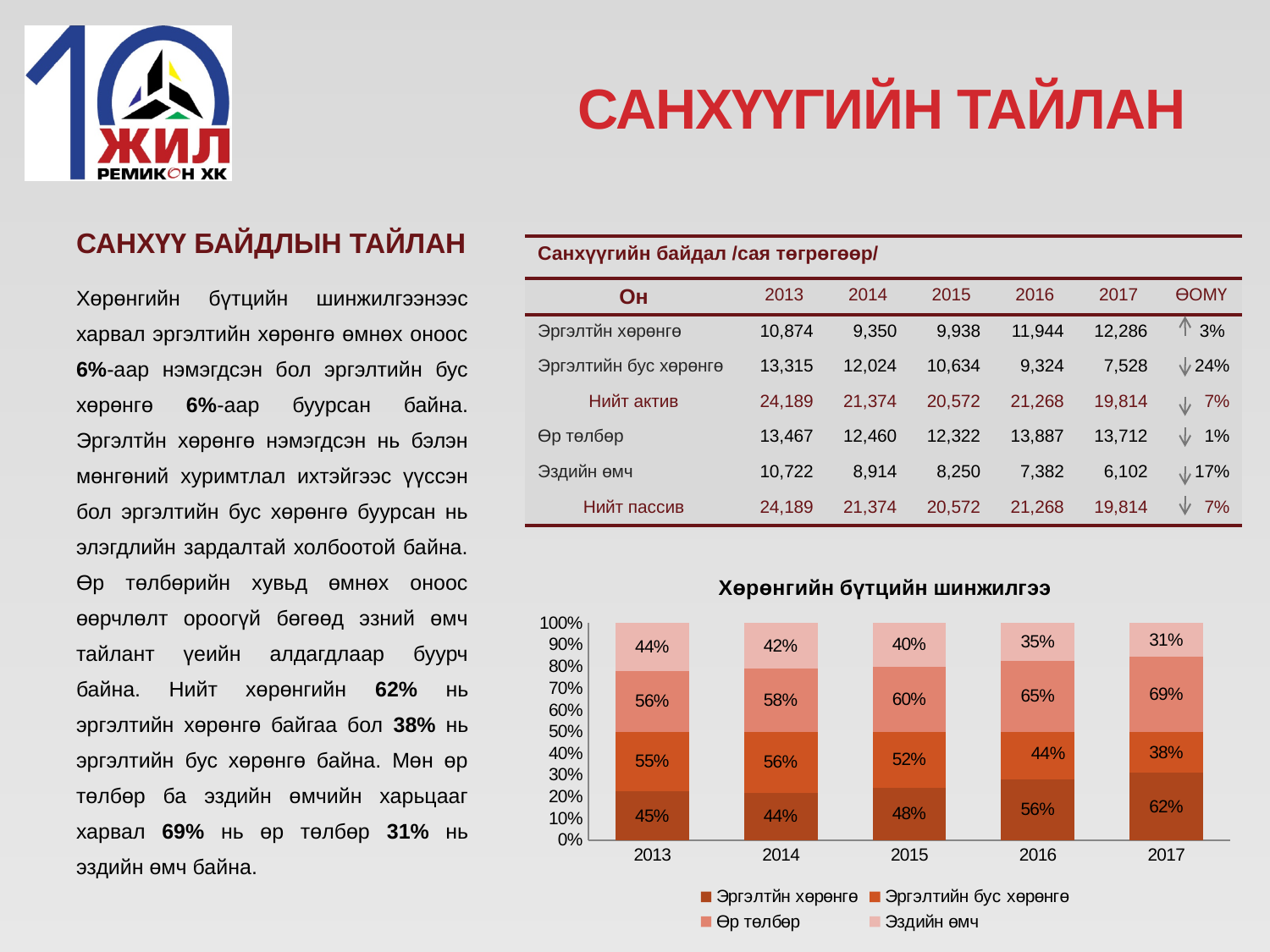
How many years are shown on the x axis of the "Хөрөнгийн бүтцийн шинжилгээ" chart? 5 What type of chart is shown under the title "Хөрөнгийн бүтцийн шинжилгээ"? stacked bar chart In the "Хөрөнгийн бүтцийн шинжилгээ" chart, what is the value of Эргэлтийн бус хөрөнгө for 2016? 44% In the "Хөрөнгийн бүтцийн шинжилгээ" chart, does the value of Эргэлтийн бус хөрөнгө rise or fall from 2014 to 2017? fall In the "Хөрөнгийн бүтцийн шинжилгээ" chart, what is the value of Эздийн өмч for 2013? 44% In the "Хөрөнгийн бүтцийн шинжилгээ" chart, which year has the lowest value for Эздийн өмч? 2017 In the "Хөрөнгийн бүтцийн шинжилгээ" chart, what is the value of Өр төлбөр for 2015? 60% In the "Хөрөнгийн бүтцийн шинжилгээ" chart, which is larger: Эргэлтйн хөрөнгө in 2014 or Эргэлтйн хөрөнгө in 2016? 2016 How many series does the legend of the "Хөрөнгийн бүтцийн шинжилгээ" chart list? 4 In the "Хөрөнгийн бүтцийн шинжилгээ" chart, what is the difference between the Өр төлбөр values for 2017 and 2013? 13% In the "Хөрөнгийн бүтцийн шинжилгээ" chart, what is the value of Эргэлтйн хөрөнгө for 2017? 62% In the "Хөрөнгийн бүтцийн шинжилгээ" chart, which year has the highest value for Эргэлтйн хөрөнгө? 2017